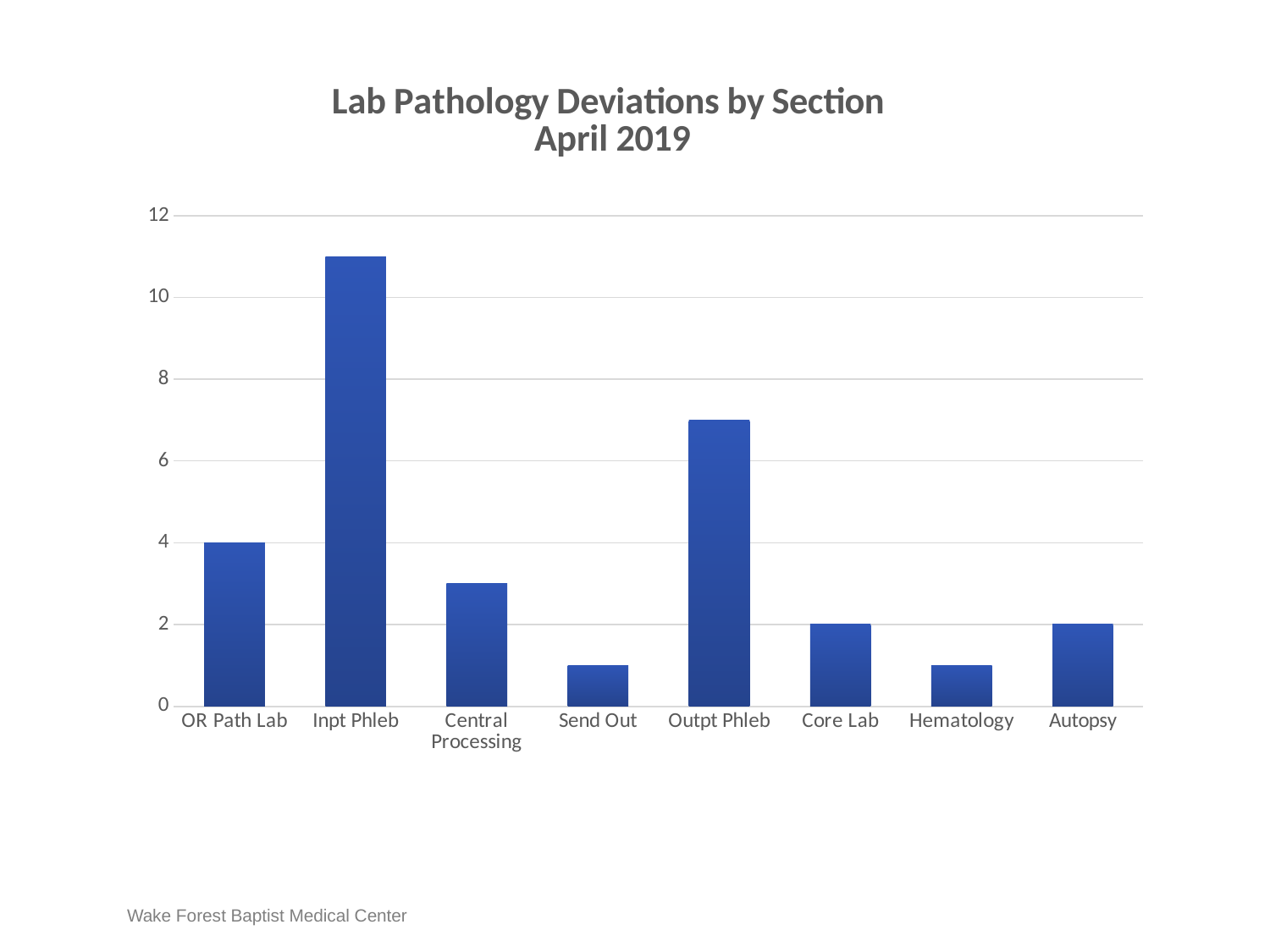
Is the value for Send Out greater or less than 2? less What is the difference between the values for OR Path Lab and Core Lab? 2 What type of chart is shown on the slide? Bar chart How many sections are shown on the x axis of the chart? 8 What is the value for OR Path Lab? 4 What is the value for Autopsy? 2 What is the value for Core Lab? 2 Is the value for Inpt Phleb greater or less than 10? greater Which has a larger value, Inpt Phleb or Outpt Phleb? Inpt Phleb What is the title of the chart? Lab Pathology Deviations by Section April 2019 Which section has the highest number of deviations? Inpt Phleb Is the value for Outpt Phleb greater or less than 6? greater